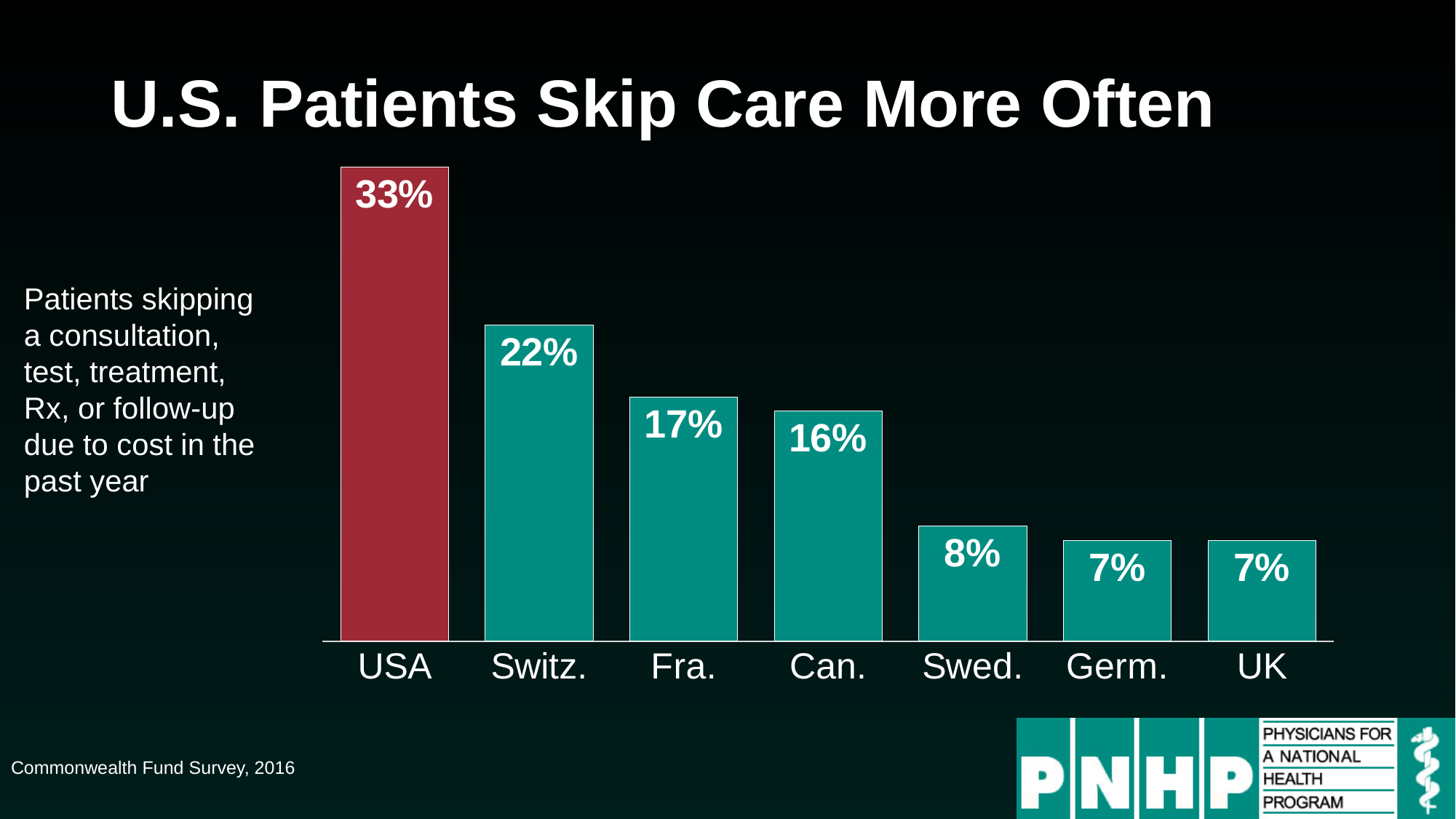
What is the value for Switz.? 22% What is the difference between the values for Fra. and Can.? 1% What is the value for Can.? 16% What is the value for USA? 33% What kind of chart is shown on the slide? Bar chart Do the values rise or fall from left to right across the chart? Fall What is the value for Swed.? 8% Which bar is coloured differently from the others? USA Which country has the highest value? USA How many countries are shown in the chart? 7 What is the difference between the values for USA and Switz.? 11% Which is larger, the value for Fra. or the value for Swed.? Fra.